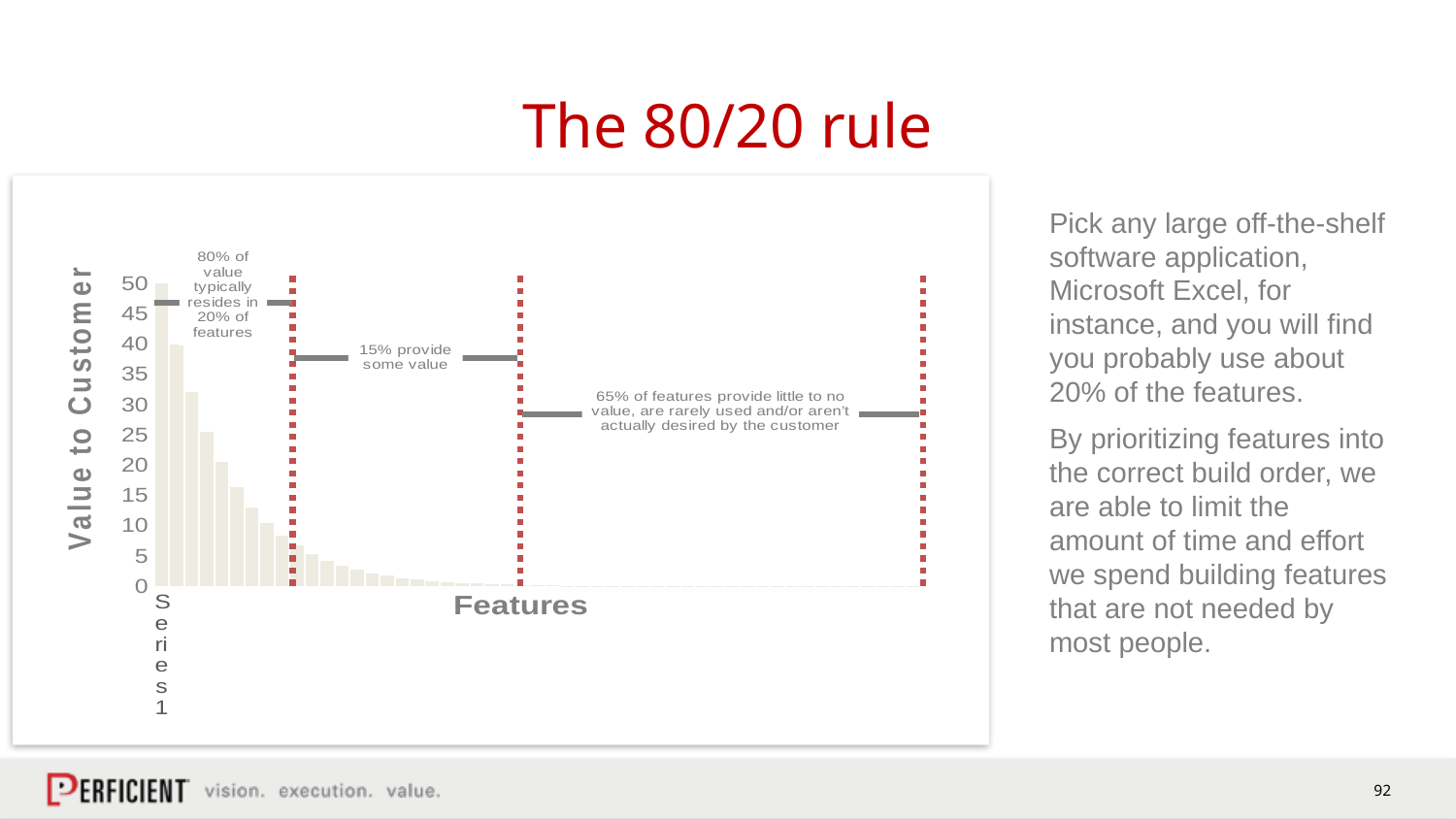
Are the values of the bars in the right-hand section (to the right of the second dashed line) greater or less than 5? less What is the title of the y axis? Value to Customer What is the title of the x axis? Features Do the bar values rise or fall moving from left to right along the x axis? fall What kind of chart is shown on the slide? bar chart Is the value of the leftmost (tallest) bar greater or less than 40? greater Is the value of the fourth bar from the left greater or less than 20? greater Which bar is the highest in the chart? the leftmost bar